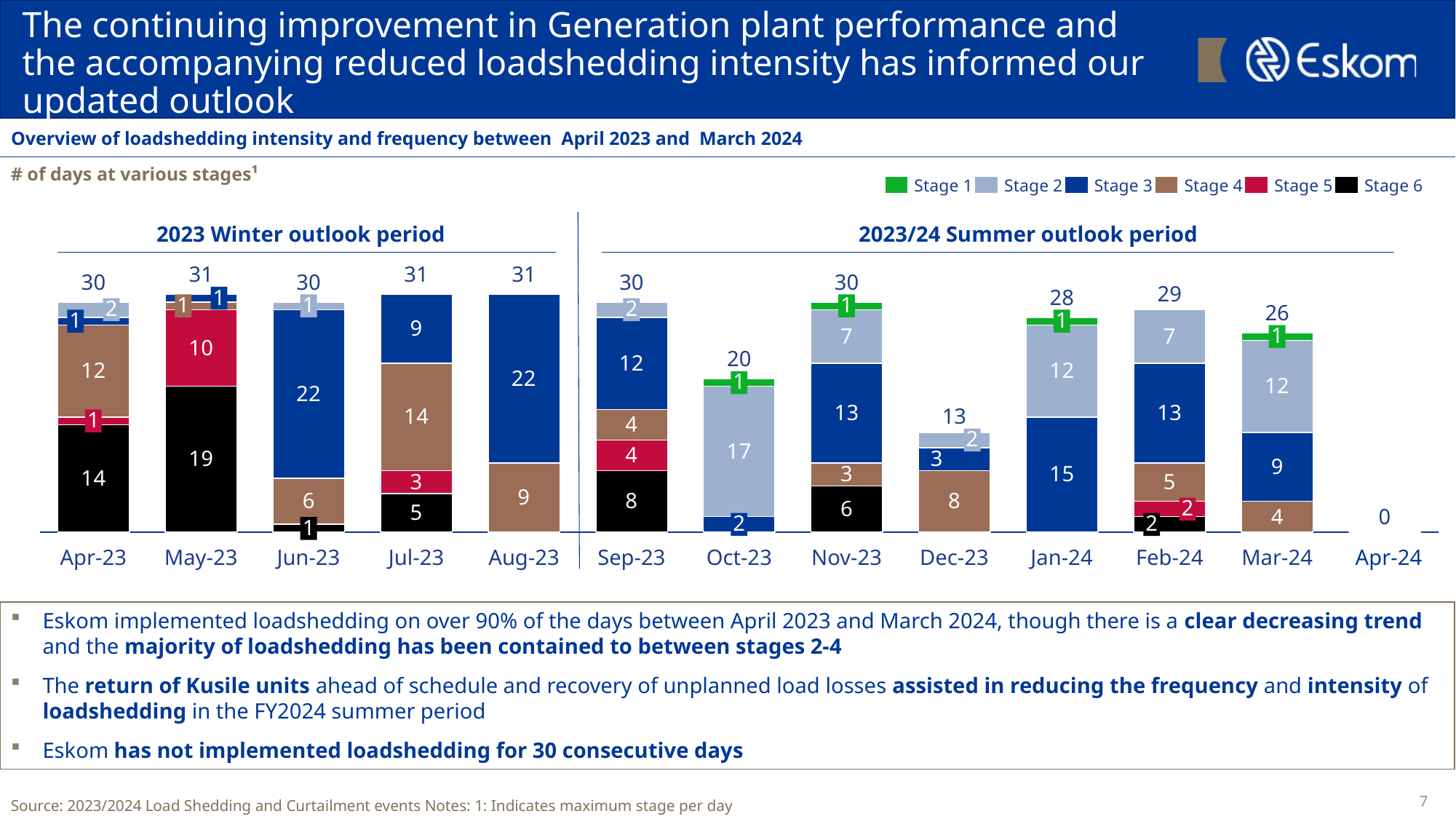
How many Stage 3 days are shown for Aug-23? 22 What is the total number of loadshedding days shown for Mar-24? 26 What is the difference in Stage 6 days between May-23 and Apr-23? 5 Which month has more Stage 3 days, Jun-23 or Jul-23? Jun-23 How many Stage 2 days are shown for Oct-23? 17 Which legend entry is shown in green? Stage 1 How many series does the legend list? 6 How many months are shown along the x axis of the chart? 13 How many Stage 6 days are shown for May-23? 19 What is the total number of loadshedding days shown for Dec-23? 13 Which month has the lowest total number of loadshedding days? Apr-24 What kind of chart is shown on the slide? Stacked bar chart